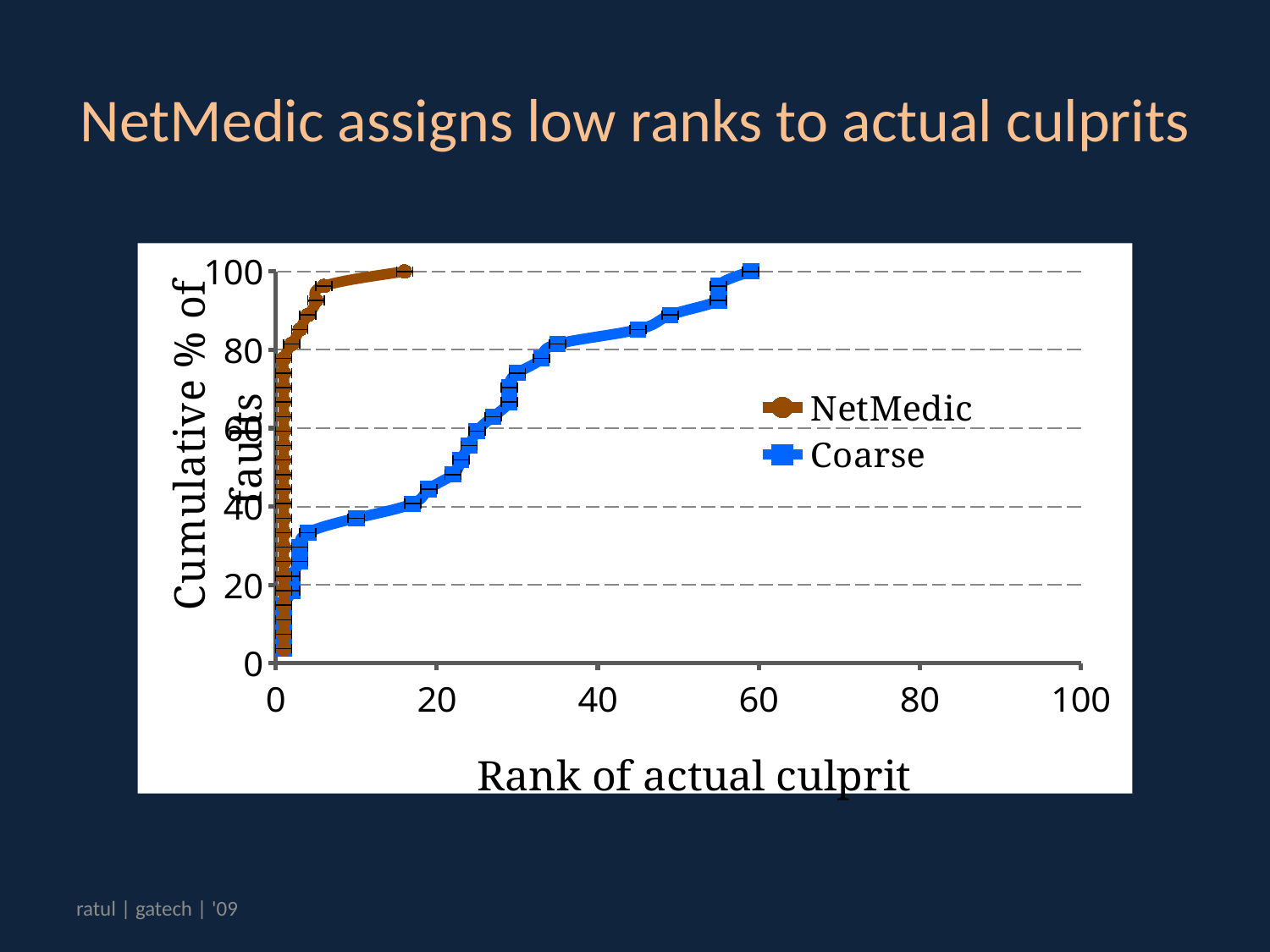
At a rank of 20, is the cumulative % of faults for NetMedic greater or less than 80? greater Do the values of the NetMedic series rise or fall along the x axis? rise What are the two series named in the legend? NetMedic and Coarse At a rank of 10, which series has the higher cumulative % of faults, NetMedic or Coarse? NetMedic What is the label of the x axis? Rank of actual culprit At a rank of 5, is the cumulative % of faults for NetMedic greater or less than 80? greater At a rank of 40, is the cumulative % of faults for Coarse greater or less than 60? greater What kind of chart is shown on the slide? line chart Which series reaches 100% cumulative faults at a lower rank? NetMedic How many series does the legend list? 2 Do the values of the Coarse series rise or fall as the rank of actual culprit increases? rise